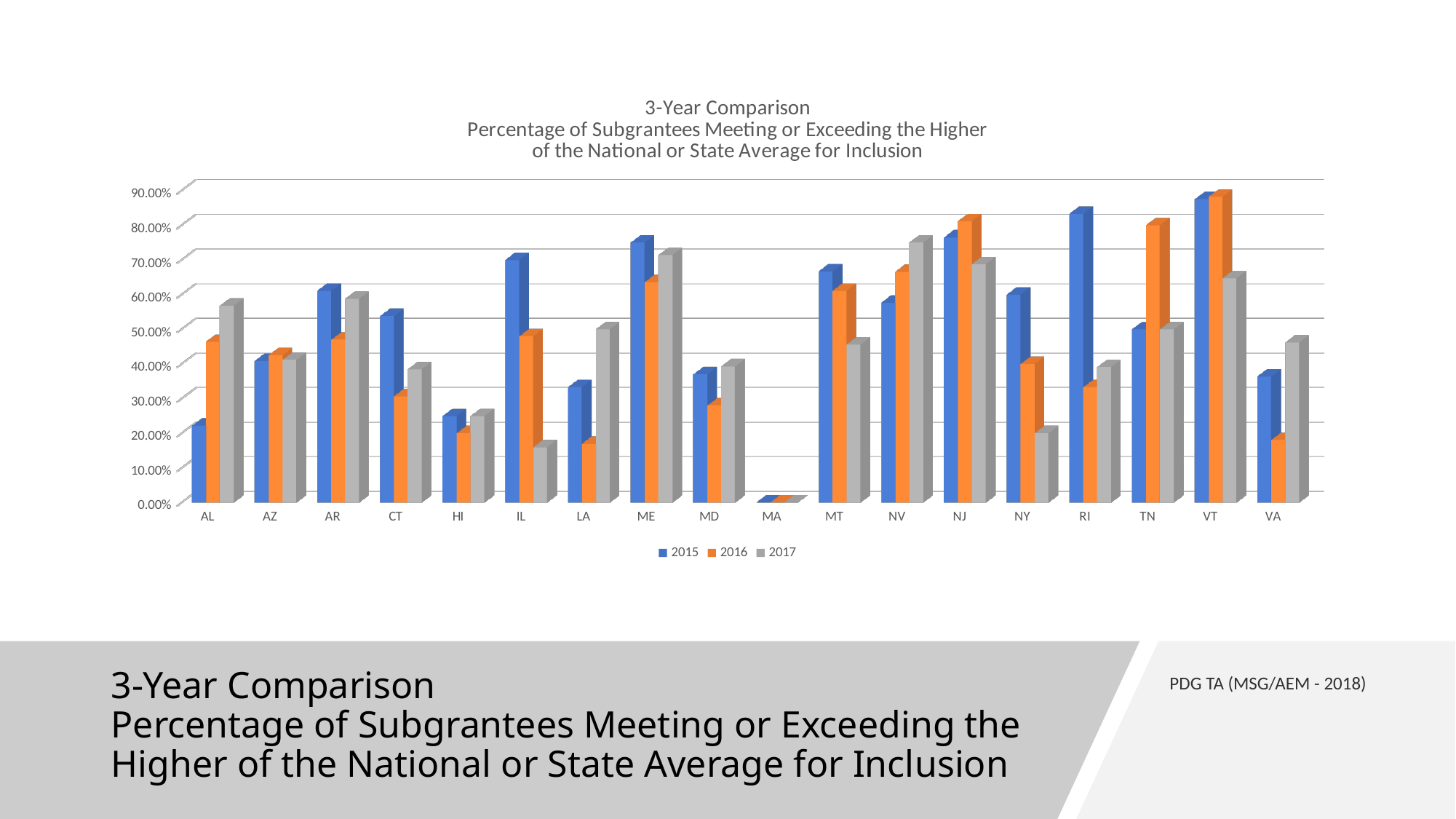
For NV, which year has the larger value, 2015 or 2017? 2017 Is the 2017 value for NY greater or less than 30.00%? less Which state has the highest 2016 value in the chart? VT For RI, which year has the larger value, 2015 or 2016? 2015 How many states are shown along the x axis of the chart? 18 Which colour represents the 2016 series in the legend? Orange Is the 2015 value for AL greater or less than 30.00%? less Is the 2015 value for IL greater or less than 60.00%? greater What kind of chart is shown on the slide? Bar chart Which state shows no visible bars for any year (the lowest values)? MA How many series does the chart legend list? 3